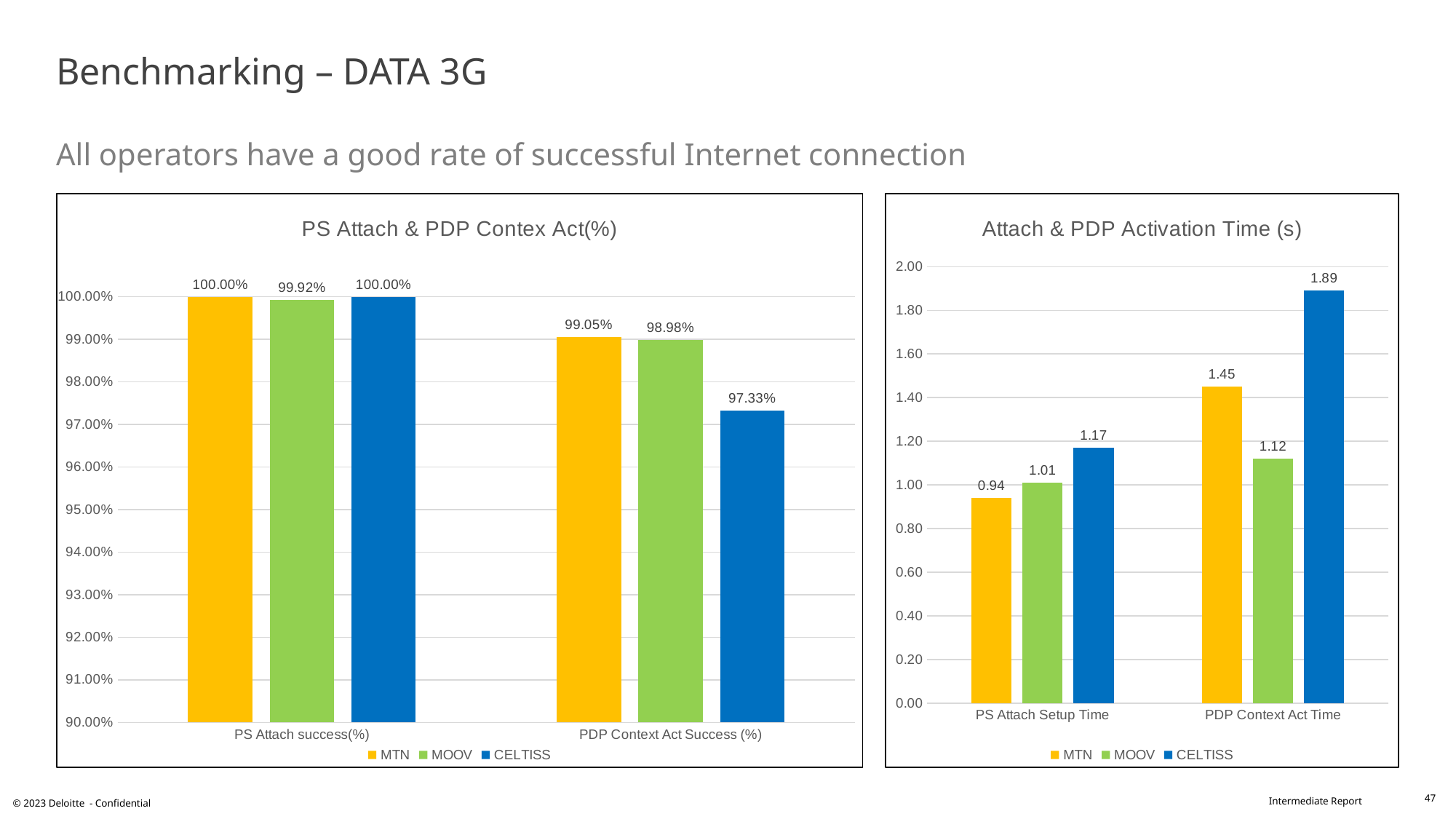
In the 'Attach & PDP Activation Time (s)' chart, which operator has the highest PDP Context Act Time? CELTISS In the 'PS Attach & PDP Contex Act(%)' chart, how many series does the legend list? 3 In the 'PS Attach & PDP Contex Act(%)' chart, what is the value for CELTISS for PDP Context Act Success (%)? 97.33% In the 'PS Attach & PDP Contex Act(%)' chart, which operator has the lowest PDP Context Act Success (%)? CELTISS In the 'Attach & PDP Activation Time (s)' chart, what is the PS Attach Setup Time for MTN? 0.94 In the 'PS Attach & PDP Contex Act(%)' chart, what is the value for MOOV for PS Attach success(%)? 99.92% In the 'Attach & PDP Activation Time (s)' chart, what is the PDP Context Act Time for CELTISS? 1.89 In the 'PS Attach & PDP Contex Act(%)' chart, what is the difference between MTN and MOOV for PDP Context Act Success (%)? 0.07% In the 'Attach & PDP Activation Time (s)' chart, which operator has the lowest PS Attach Setup Time? MTN In the 'Attach & PDP Activation Time (s)' chart, what is the difference between CELTISS and MOOV for PDP Context Act Time? 0.77 What kind of chart is the 'Attach & PDP Activation Time (s)' chart? Bar chart In the 'Attach & PDP Activation Time (s)' chart, which is larger: MOOV's PS Attach Setup Time or MOOV's PDP Context Act Time? PDP Context Act Time